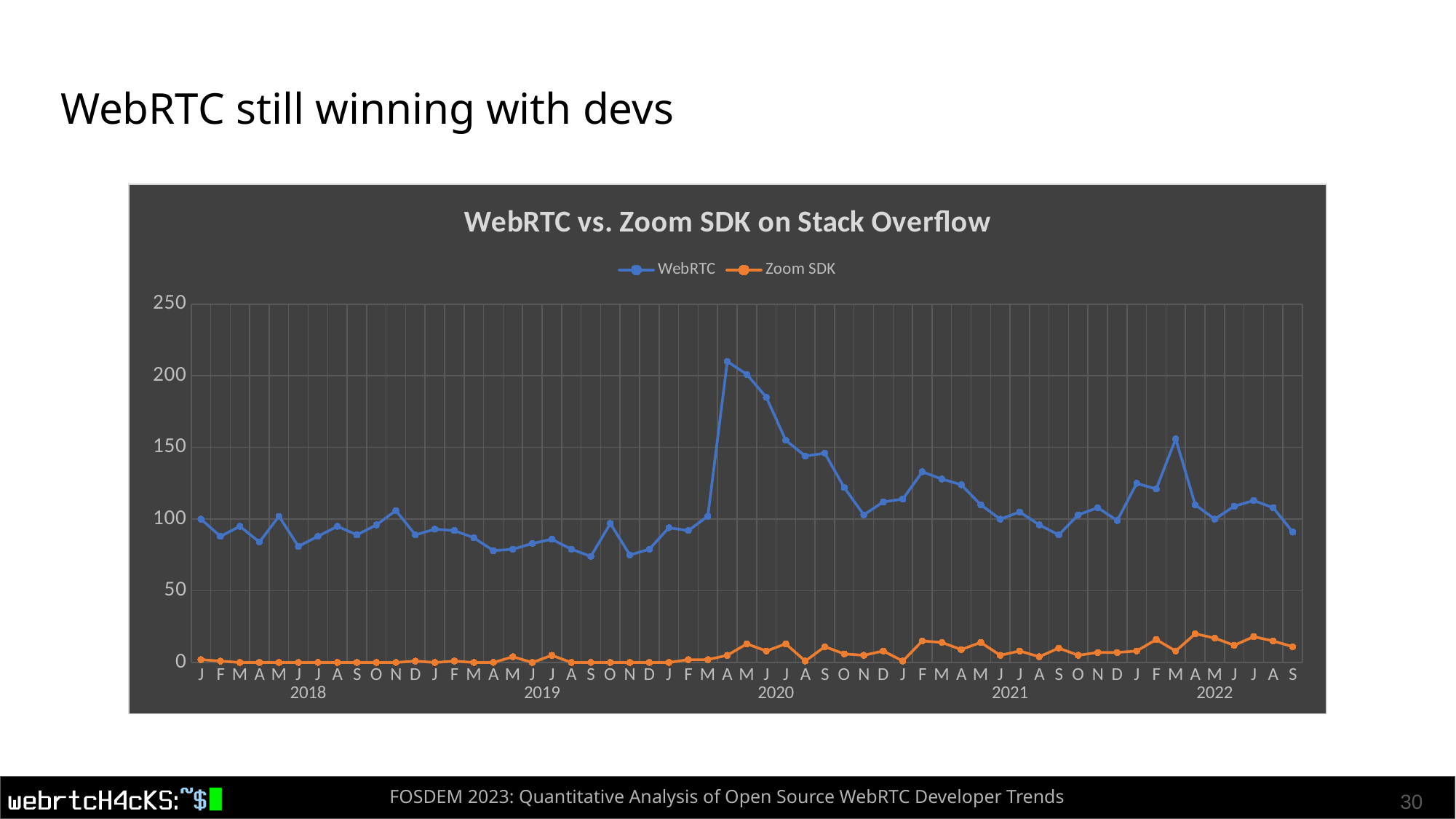
What is the last month shown on the x axis? September 2022 What is the title of the chart? WebRTC vs. Zoom SDK on Stack Overflow Is the WebRTC value for September 2019 greater or less than 100? less Is the Zoom SDK value for April 2020 greater or less than 50? less Is the WebRTC value for March 2022 greater or less than 150? greater What kind of chart is shown on the slide? line chart Which series is drawn in orange? Zoom SDK Which series has the higher values throughout the chart, WebRTC or Zoom SDK? WebRTC In which month and year does the WebRTC series reach its highest value? April 2020 Does the WebRTC series rise or fall between April 2020 and December 2020? fall How many series does the legend list? 2